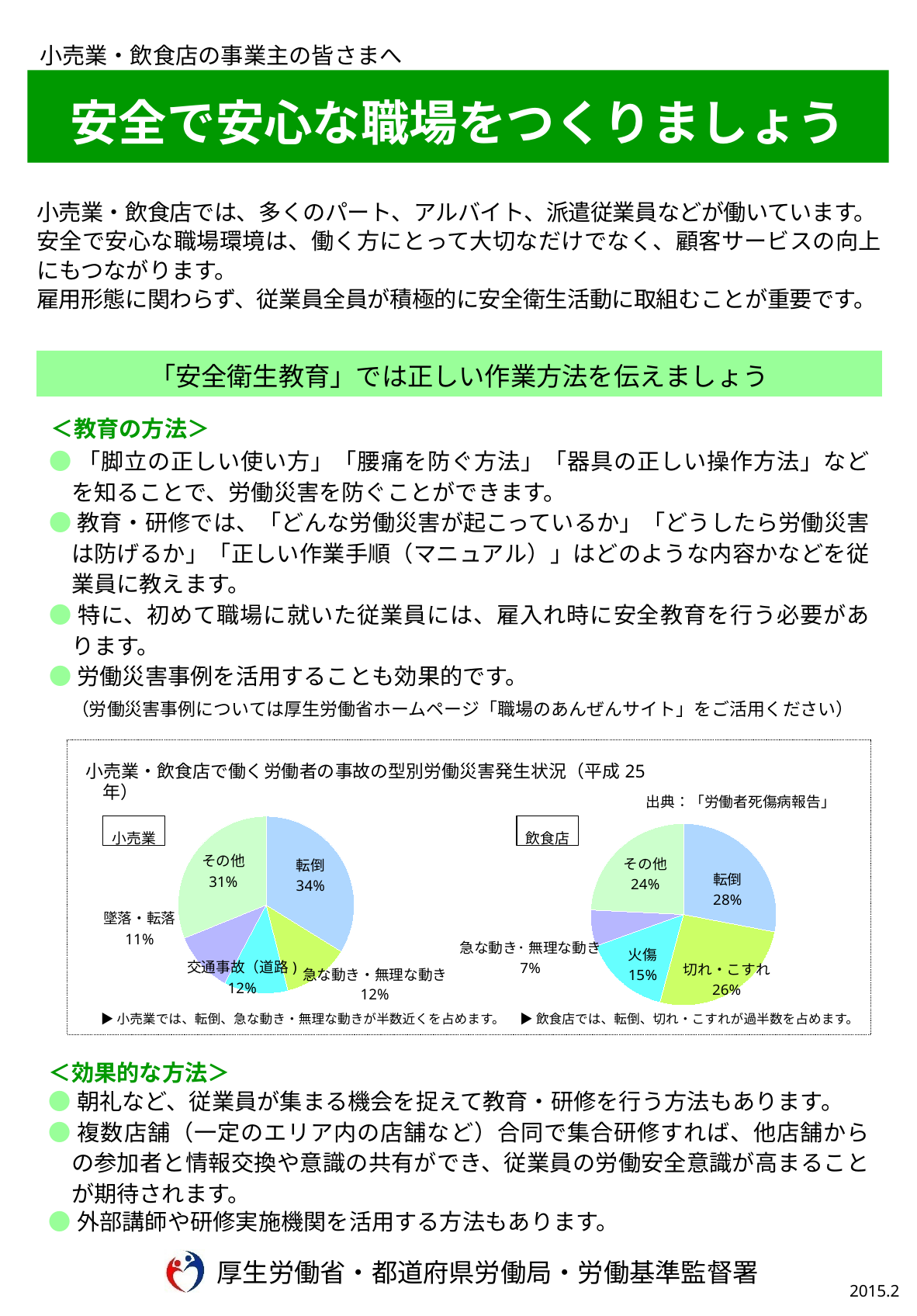
How many slices does the 飲食店 pie chart have? 5 What type of chart is used for 小売業 and 飲食店? Pie chart In the 小売業 pie chart, what share is 墜落・転落? 11% In the 小売業 pie chart, which category has the largest share? 転倒 What is the source cited for the charts? 「労働者死傷病報告」 Which is larger: 急な動き・無理な動き in the 小売業 chart or in the 飲食店 chart? 小売業 In the 飲食店 pie chart, which category has the smallest share? 急な動き・無理な動き In the 小売業 pie chart, what is the difference between 転倒 and その他? 3% In the 小売業 pie chart, what share is 転倒? 34% In the 飲食店 pie chart, what share is 切れ・こすれ? 26% In the 飲食店 pie chart, what share is 火傷? 15% In the 飲食店 pie chart, what is the difference between 転倒 and 火傷? 13%